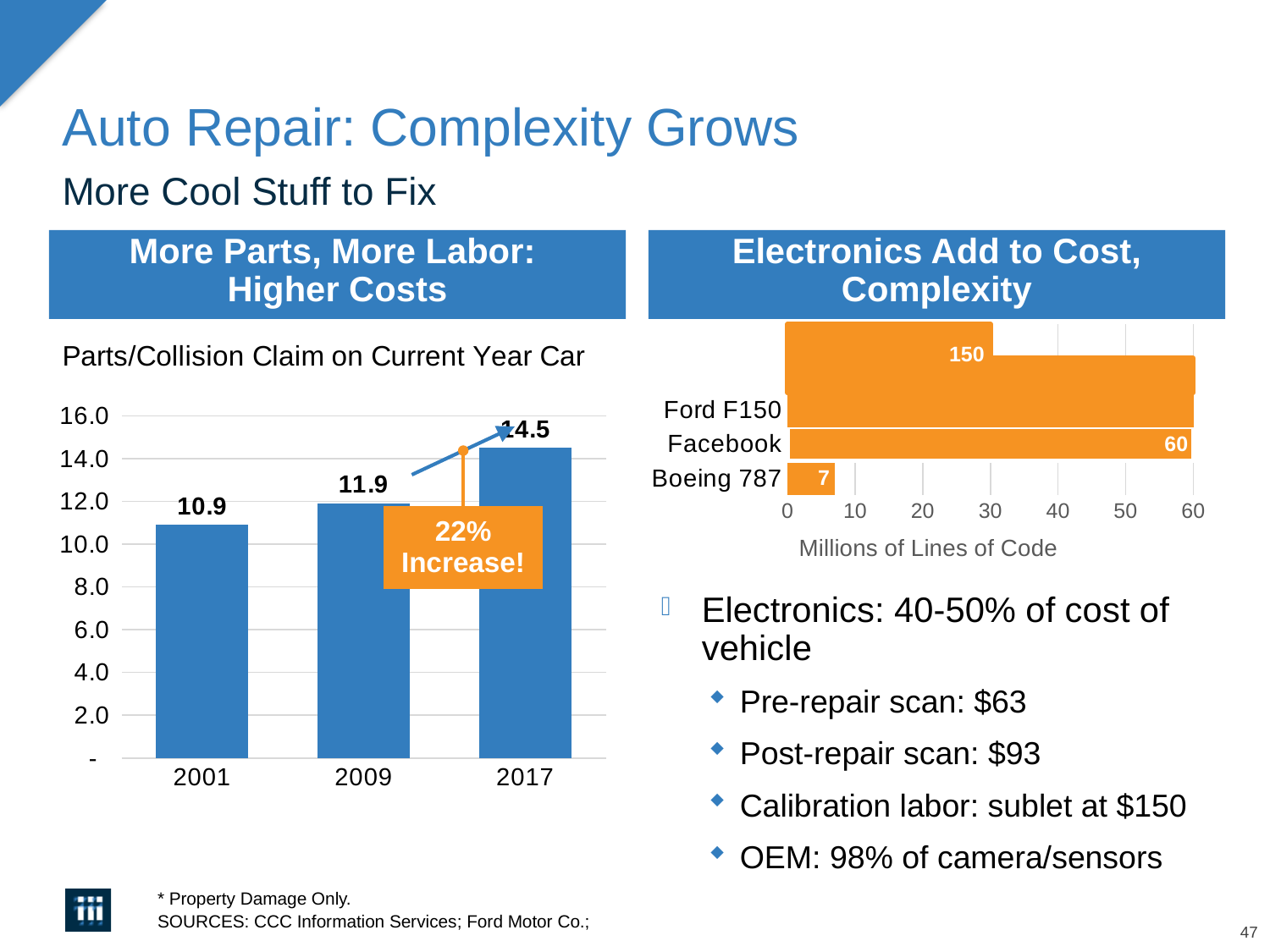
What kind of chart is the Millions of Lines of Code chart? bar chart In the Millions of Lines of Code chart, what is the value for Boeing 787? 7 In the Millions of Lines of Code chart, what is the difference between the Ford F150 and Facebook values? 90 In the Parts/Collision Claim on Current Year Car chart, what is the value for 2017? 14.5 In the Parts/Collision Claim on Current Year Car chart, which year has the highest value? 2017 In the Millions of Lines of Code chart, which category has the lowest value? Boeing 787 In the Parts/Collision Claim on Current Year Car chart, do the values rise or fall from 2001 to 2017? rise In the Parts/Collision Claim on Current Year Car chart, which year has the lowest value? 2001 How many years are shown in the Parts/Collision Claim on Current Year Car chart? 3 In the Parts/Collision Claim on Current Year Car chart, what is the difference between the 2017 and 2009 values? 2.6 In the Millions of Lines of Code chart, what is the value for Ford F150? 150 In the Parts/Collision Claim on Current Year Car chart, what is the value for 2001? 10.9